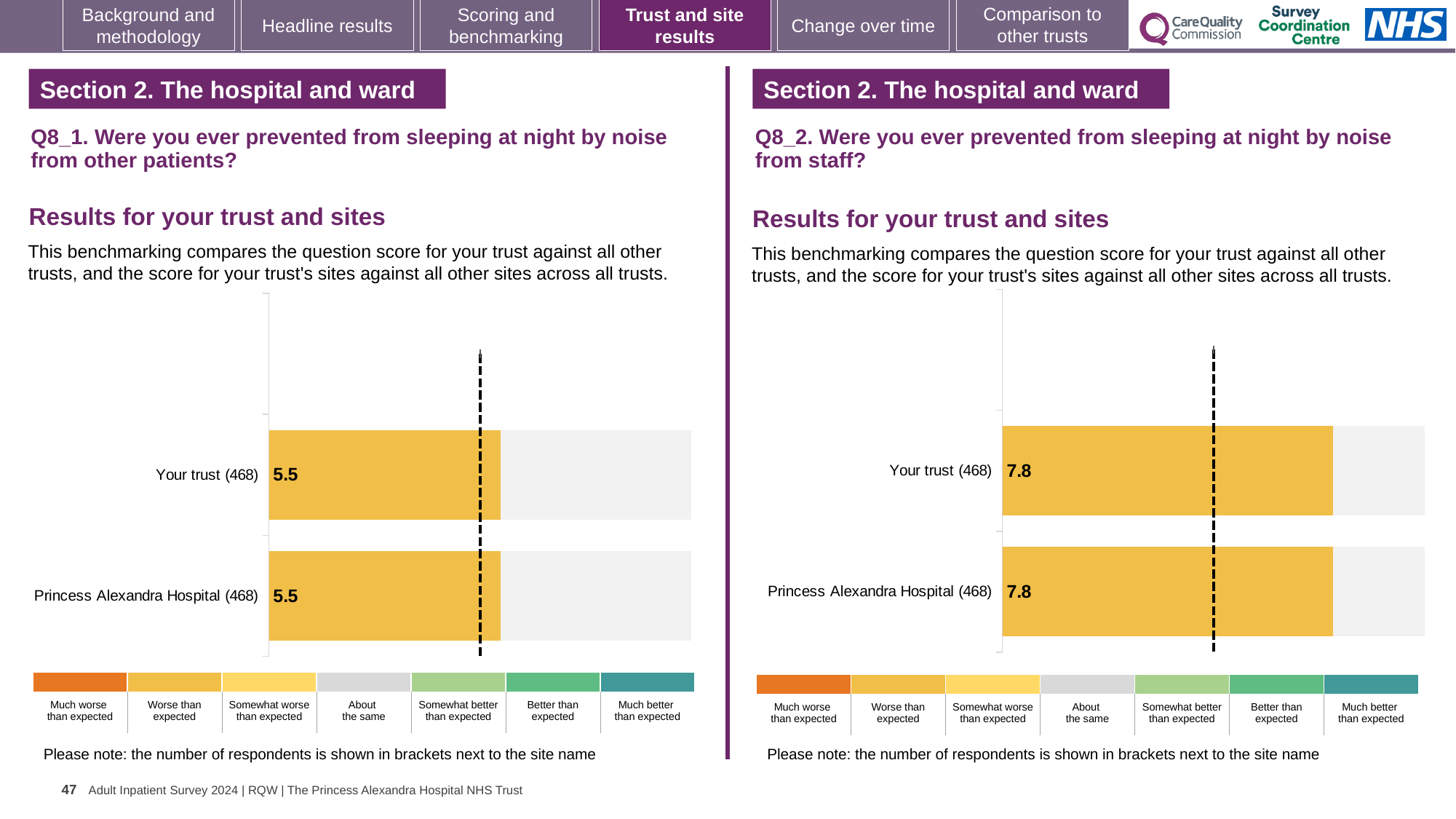
On the left chart (Q8_1, noise from other patients), what is the score for Princess Alexandra Hospital? 5.5 On the right chart (Q8_2), what is the difference between the score for Your trust and the score for Princess Alexandra Hospital? 0.0 How many categories does the colour legend below the left chart (Q8_1) list? 7 On the right chart (Q8_2, noise from staff), what is the score for Your trust? 7.8 On the right chart (Q8_2), which benchmark category does the colour of the bars correspond to in the legend? Worse than expected On the left chart (Q8_1, noise from other patients), what is the score for Your trust? 5.5 On the left chart (Q8_1), what is the difference between the score for Your trust and the score for Princess Alexandra Hospital? 0.0 How many bars are plotted on the right chart (Q8_2)? 2 How many bars are plotted on the left chart (Q8_1)? 2 On the right chart (Q8_2, noise from staff), what is the score for Princess Alexandra Hospital? 7.8 On the left chart (Q8_1), how many respondents are shown in brackets next to Your trust? 468 What type of chart is used on the left (Q8_1) to show the results for your trust and sites? Bar chart